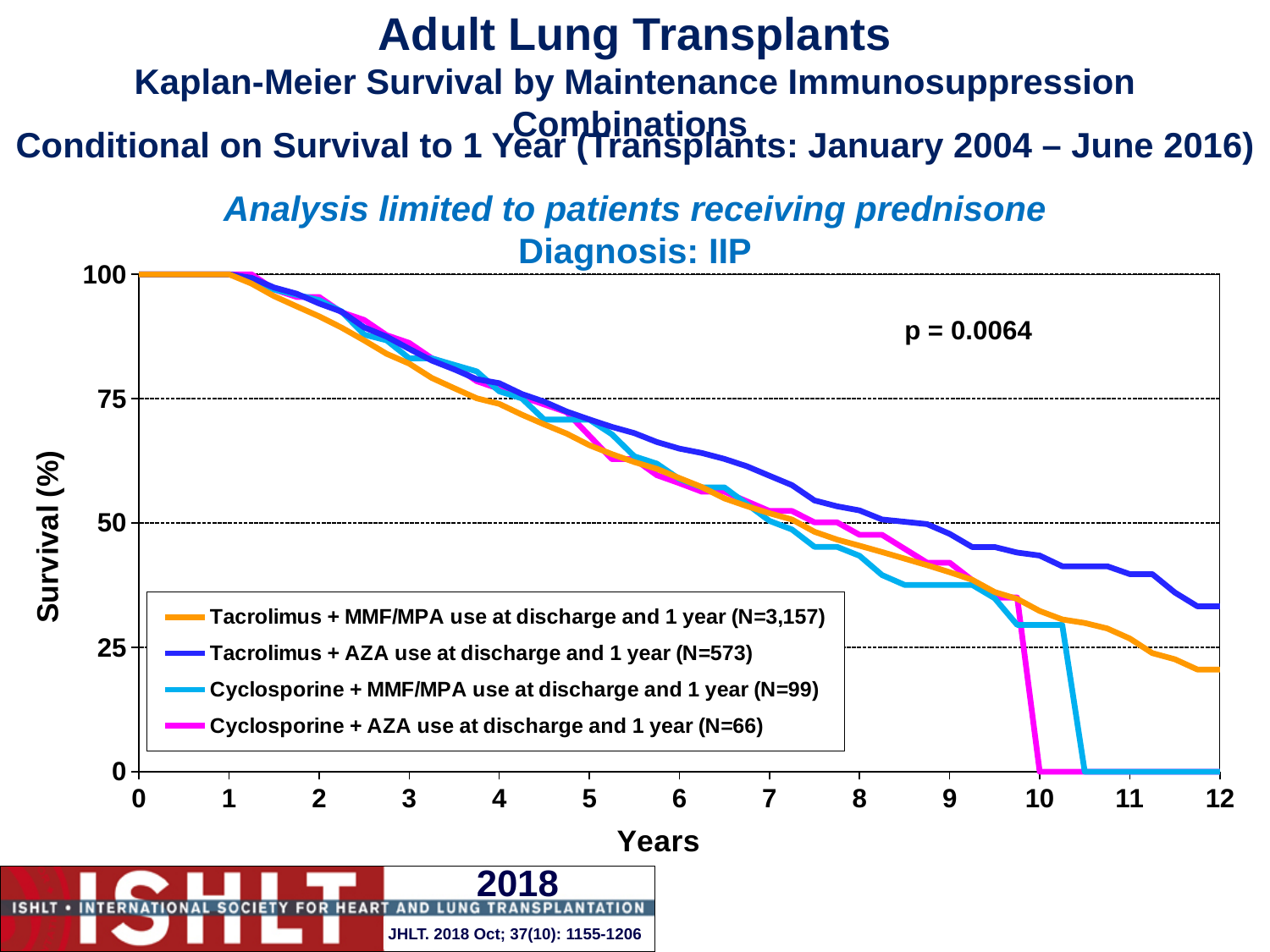
What is the survival value for all four groups at 1 year? 100 Is the survival value for Tacrolimus + MMF/MPA at 3 years greater or less than 75? greater Is the survival value for Tacrolimus + MMF/MPA at 12 years greater or less than 25? less Is the survival value for Tacrolimus + AZA at 12 years greater or less than 25? greater How many series does the legend list? 4 What kind of chart is shown on the slide? Line chart At 12 years, which is higher: Tacrolimus + AZA or Tacrolimus + MMF/MPA? Tacrolimus + AZA Do the survival curves rise or fall as years increase? Fall What is the label of the y axis? Survival (%) Which group has the highest survival at 12 years? Tacrolimus + AZA use at discharge and 1 year (N=573) What is the survival value for Cyclosporine + AZA use at discharge and 1 year at 12 years? 0 What p-value is printed on the chart? p = 0.0064